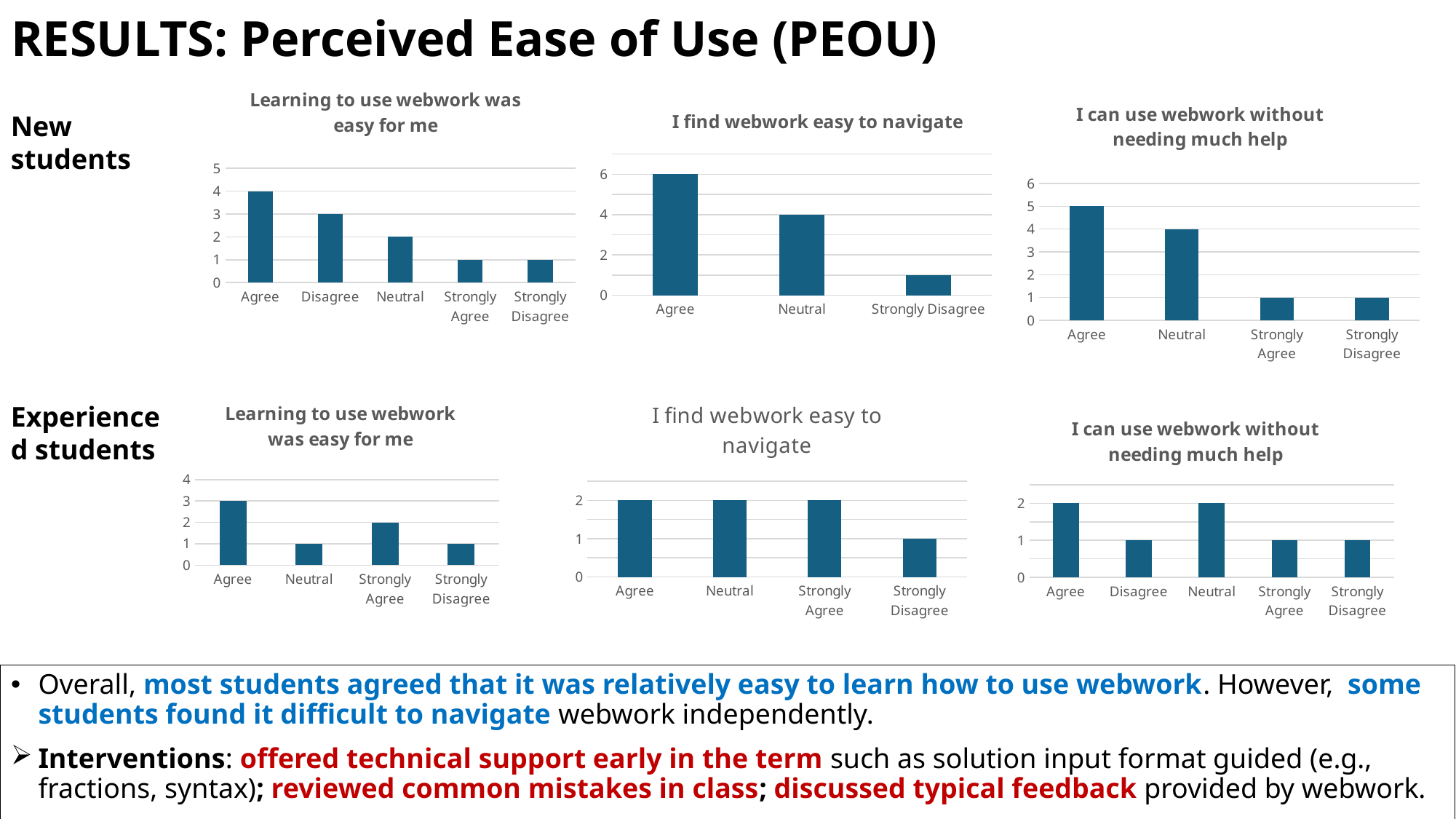
In the New students chart 'Learning to use webwork was easy for me', what is the value for Agree? 4 In the Experienced students chart 'I can use webwork without needing much help', how many categories are shown on the x axis? 5 In the New students chart 'I find webwork easy to navigate', how many categories are shown on the x axis? 3 In the New students chart 'Learning to use webwork was easy for me', which category has the highest value? Agree In the Experienced students chart 'Learning to use webwork was easy for me', which is larger, Agree or Strongly Agree? Agree In the New students chart 'I can use webwork without needing much help', what is the difference between Agree and Strongly Agree? 4 What type of chart is used for the Experienced students chart 'I can use webwork without needing much help'? Bar chart In the Experienced students chart 'Learning to use webwork was easy for me', what is the value for Strongly Agree? 2 In the New students chart 'I find webwork easy to navigate', what is the value for Agree? 6 In the New students chart 'I can use webwork without needing much help', what is the value for Neutral? 4 In the Experienced students chart 'I find webwork easy to navigate', which category has the lowest value? Strongly Disagree In the New students chart 'I find webwork easy to navigate', is the value for Strongly Disagree greater or less than 2? less